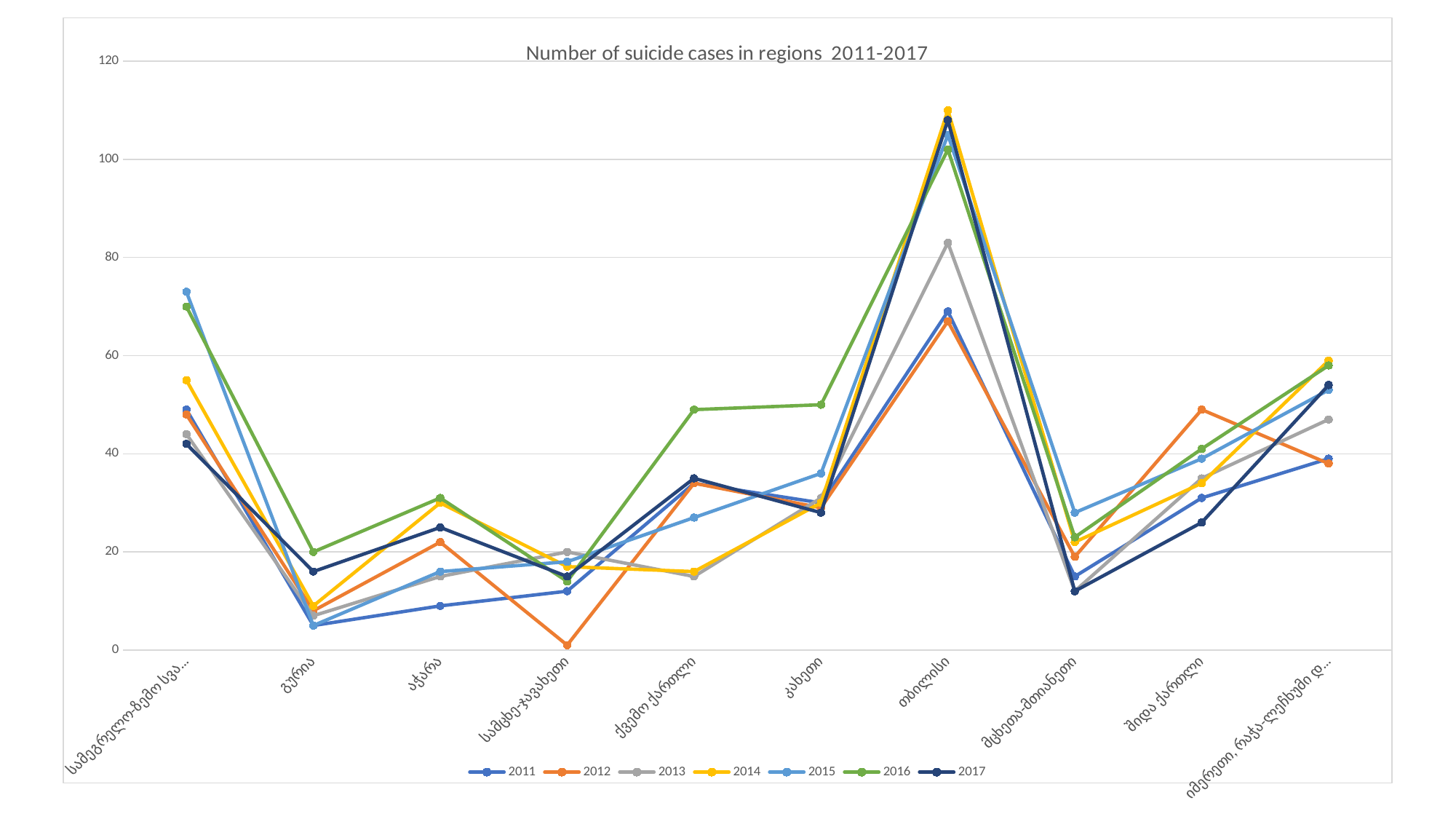
Is the 2014 value for თბილისი greater or less than 100? greater For the 2016 series, do the values rise or fall from მცხეთა-მთიანეთი to the last region on the x axis? rise For თბილისი, which series has the larger value, 2014 or 2013? 2014 How many series does the legend list? 7 Is the 2012 value for სამცხე-ჯავახეთი greater or less than 20? less Is the 2017 value for მცხეთა-მთიანეთი greater or less than 20? less What is the title of the chart? Number of suicide cases in regions 2011-2017 What kind of chart is shown on the slide? line chart Which region has the highest value for the 2016 series? თბილისი How many regions (categories) are plotted along the x axis? 10 Which region has the lowest value for the 2012 series? სამცხე-ჯავახეთი